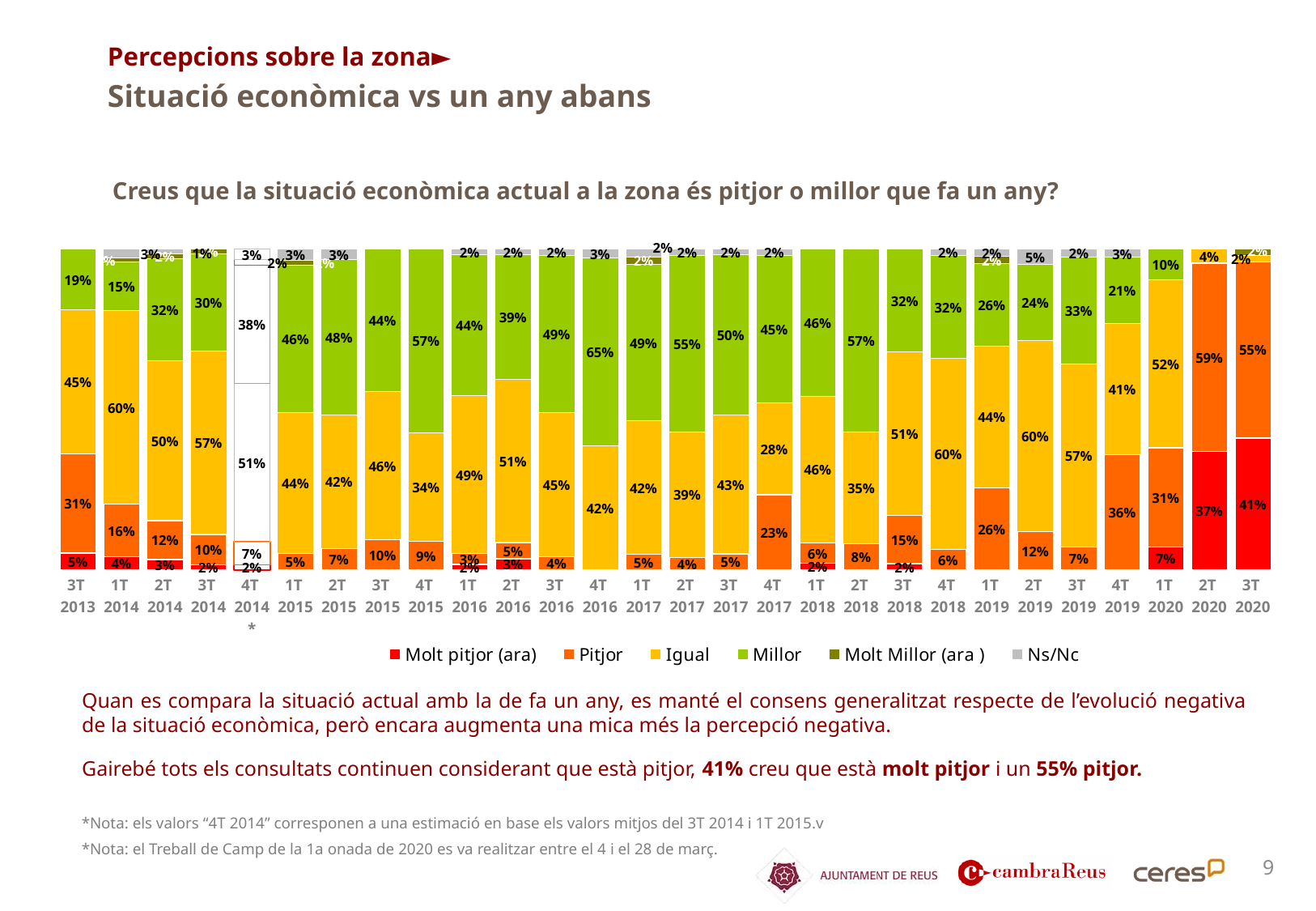
By how many percentage points is the "Pitjor" value in 2T 2020 higher than in 3T 2020? 4 percentage points Does the "Molt pitjor (ara)" share rise or fall from 1T 2020 to 3T 2020? Rise What is the "Millor" value for 4T 2016? 65% Which quarter has a larger "Igual" value, 2T 2019 or 3T 2019? 2T 2019 In which quarter is the "Molt pitjor (ara)" share the highest? 3T 2020 What percentage of respondents answered "Molt pitjor (ara)" in 3T 2020? 41% What kind of chart is shown on the slide? Stacked bar chart What is the "Igual" value for 1T 2020? 52% In which quarter is the "Millor" share the highest? 4T 2016 How many series does the legend list? 6 How many quarters (bars) are shown on the x axis? 28 What is the "Pitjor" value for 2T 2020? 59%